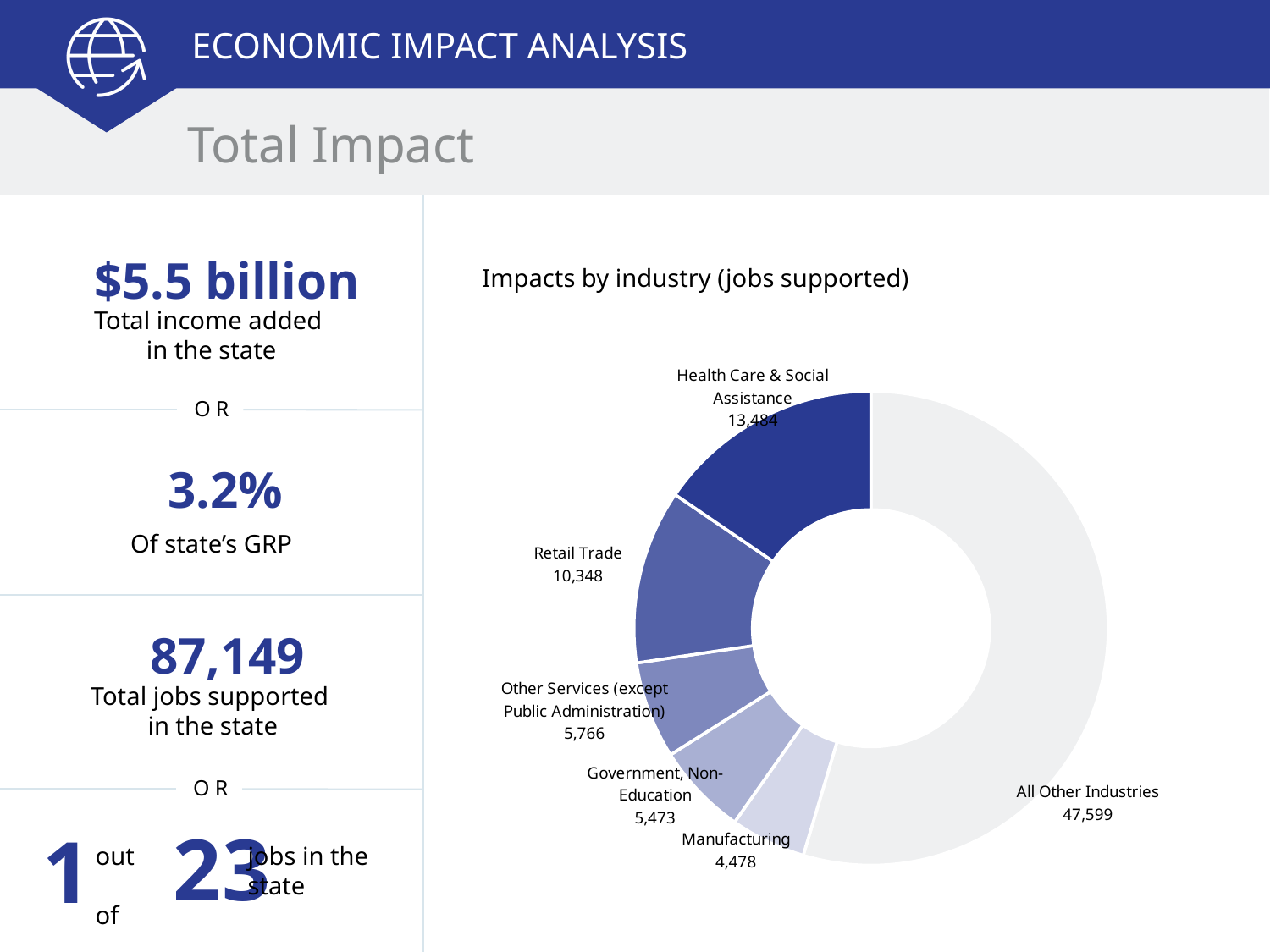
What is the title of the chart on the slide? Impacts by industry (jobs supported) What is the difference in jobs supported between Health Care & Social Assistance and Retail Trade? 3,136 How many jobs are supported in Government, Non-Education? 5,473 Which industry category has the smallest number of jobs supported? Manufacturing Which industry category has the largest number of jobs supported? All Other Industries What is the difference in jobs supported between All Other Industries and Health Care & Social Assistance? 34,115 How many jobs are supported in Health Care & Social Assistance? 13,484 How many jobs are supported in Manufacturing? 4,478 How many industry categories are shown in the chart? 6 Which supports more jobs, Retail Trade or Other Services (except Public Administration)? Retail Trade What kind of chart is used to show impacts by industry? doughnut chart How many jobs are supported in Retail Trade? 10,348